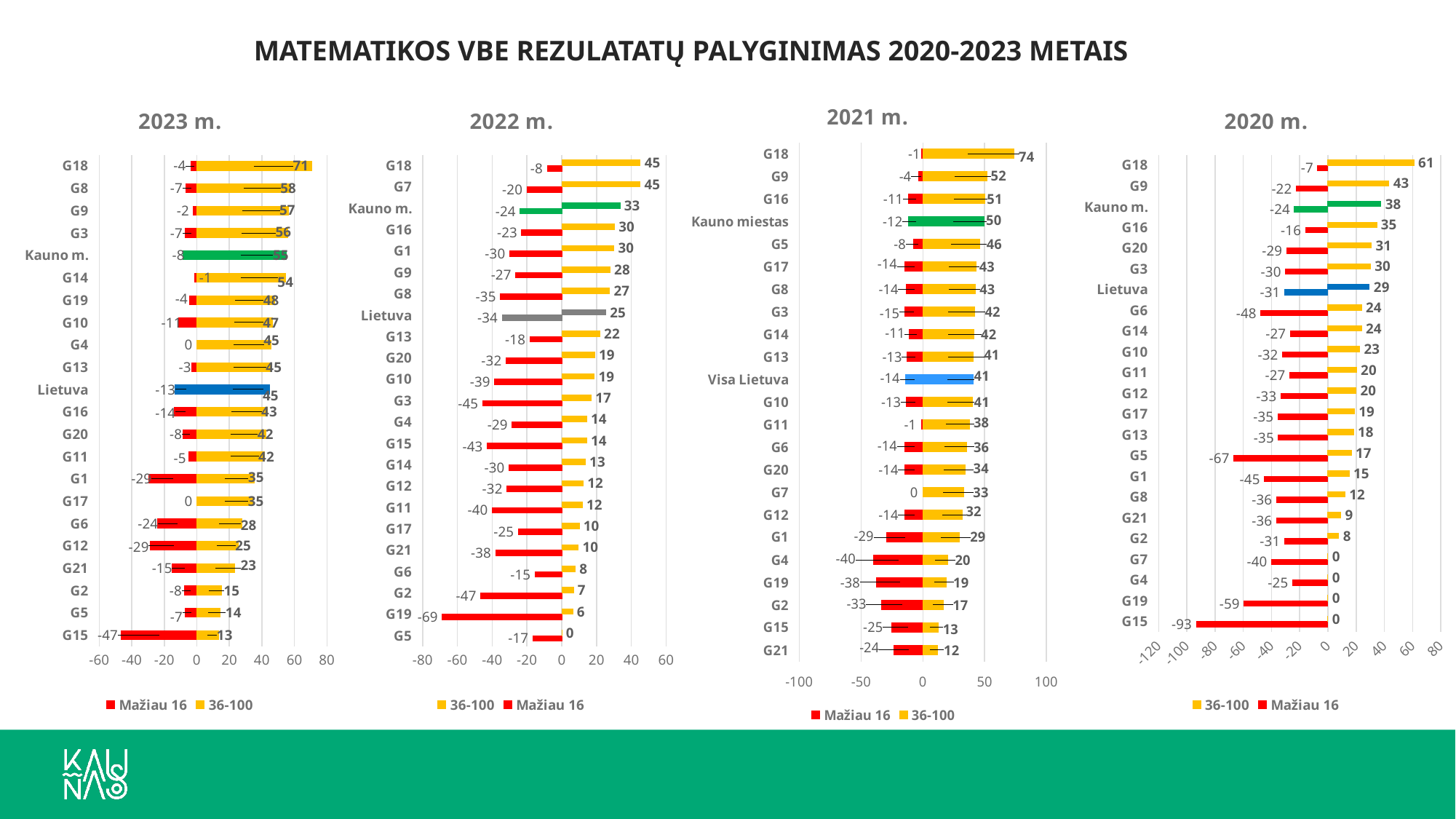
In the 2022 m. chart, what is the Mažiau 16 value for Lietuva? -34 In the 2021 m. chart, what is the 36-100 value for Kauno miestas? 50 How many series does the legend of the 2020 m. chart list? 2 In the 2023 m. chart, what is the difference between the 36-100 values of G18 and G15? 58 What type of chart is the 2022 m. chart? Bar chart In the 2020 m. chart, what is the Mažiau 16 value for Lietuva? -31 In the 2023 m. chart, what is the 36-100 value for G18? 71 In the 2020 m. chart, which category has the lowest Mažiau 16 value? G15 In the 2022 m. chart, which has the larger 36-100 value, G7 or G16? G7 How many categories are shown in the 2023 m. chart? 22 In the 2021 m. chart, which category has the highest 36-100 value? G18 In the 2023 m. chart, what colour is the 36-100 bar for Kauno m.? Green